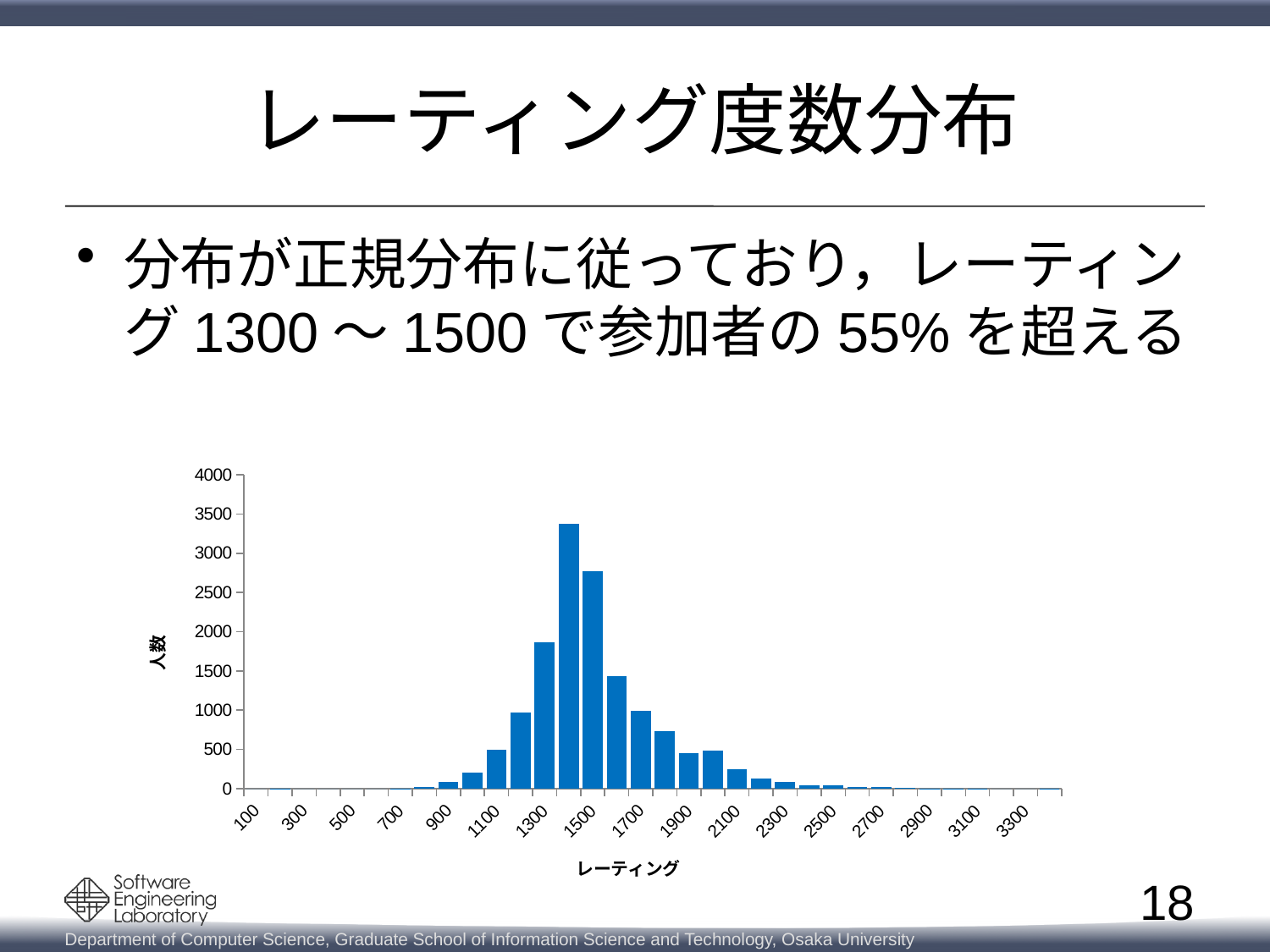
Is the value for rating 2100 greater or less than 500? less Is the value for rating 1500 greater or less than 2500? greater Is the value for rating 1300 greater or less than 1500? greater Which has more people, rating 1400 or rating 1600? 1400 How do the values change along the x axis from 100 to 3300? rise to a peak around 1400, then fall Which rating has the highest number of people (人数)? 1400 Which has more people, rating 1300 or rating 1500? 1500 What is the label of the vertical axis? 人数 What is the label of the horizontal axis? レーティング What kind of chart is shown on the slide? bar chart